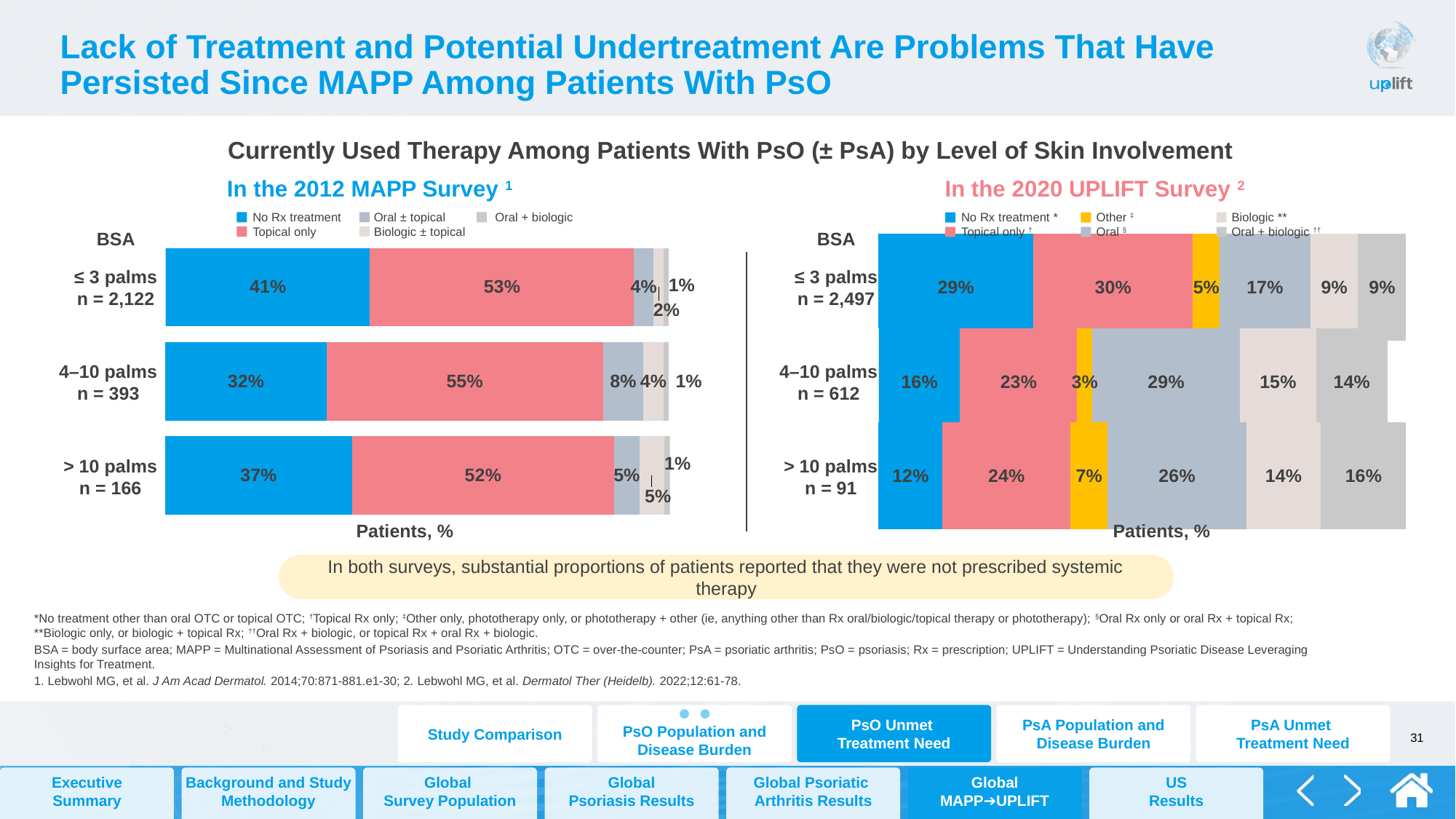
In the 2020 UPLIFT Survey chart, what percentage of patients with BSA 4–10 palms used oral therapy? 29% In the 2020 UPLIFT Survey chart, what is the sample size (n) for the BSA > 10 palms category? n = 91 How many series does the legend of the 2020 UPLIFT Survey chart list? 6 What type of chart is the 2012 MAPP Survey chart? Stacked bar chart In the 2012 MAPP Survey chart, which BSA category has the lowest percentage of patients with no Rx treatment? 4–10 palms In the 2020 UPLIFT Survey chart, which is larger for BSA > 10 palms: the oral percentage or the topical only percentage? Oral In the 2012 MAPP Survey chart, what percentage of patients with BSA ≤ 3 palms reported no Rx treatment? 41% In the 2020 UPLIFT Survey chart, which BSA category has the highest percentage of patients with no Rx treatment? ≤ 3 palms What is the difference between the no Rx treatment percentage for BSA ≤ 3 palms in the 2012 MAPP Survey chart and in the 2020 UPLIFT Survey chart? 12% In the 2012 MAPP Survey chart, what percentage of patients with BSA 4–10 palms used topical only? 55% In the 2020 UPLIFT Survey chart, what percentage of patients with BSA > 10 palms reported no Rx treatment? 12% How many BSA categories are shown in the 2012 MAPP Survey chart? 3